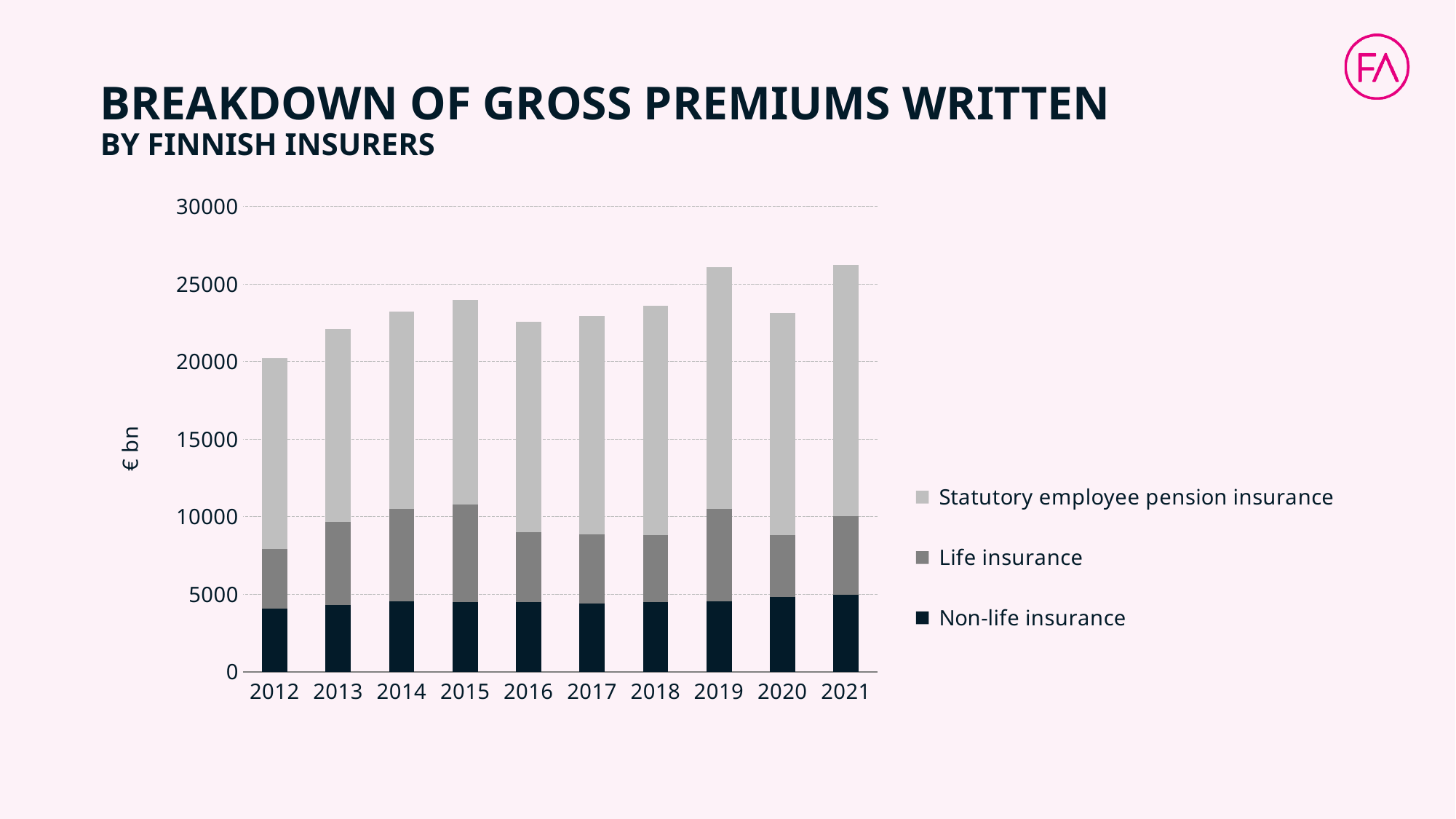
Is the total bar for 2019 greater or less than 25000? greater Which legend entry is shown in the lightest grey colour? Statutory employee pension insurance What kind of chart is shown on the slide? Stacked bar chart How many series does the chart's legend list? 3 Do the total bars rise or fall from 2012 to 2015? Rise Which year has a larger total bar, 2015 or 2016? 2015 How many years are shown on the x axis of the chart? 10 Which year has the lowest total gross premiums written? 2012 What is the label on the y axis of the chart? € bn Is the Non-life insurance value for 2012 greater or less than 5000? less Is the total bar for 2016 greater or less than 25000? less